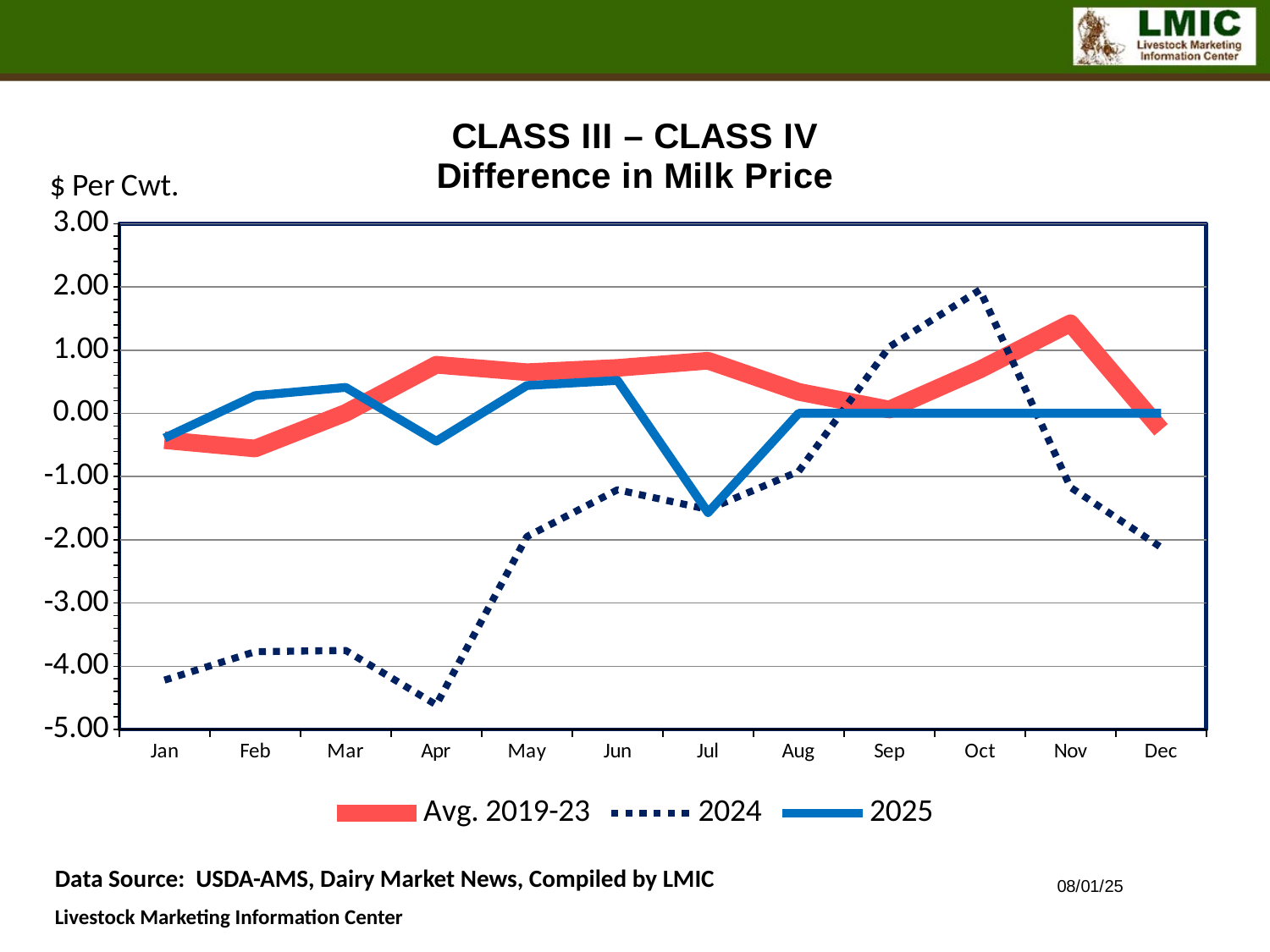
How many series does the legend list? 3 In which month does the 2024 series reach its lowest value? Apr How many months are shown along the x axis? 12 Is the 2025 value for Jul greater or less than -1.00? less Is the 2024 value for Apr greater or less than -4.00? less What kind of chart is shown on the slide? line chart Is the 2024 value for Oct greater or less than 1.00? greater Does the 2024 series generally rise or fall from Jan to Oct? rise In Jan, which series has the higher value: Avg. 2019-23 or 2024? Avg. 2019-23 What unit is shown on the y axis label? $ Per Cwt. In which month does the 2024 series reach its highest value? Oct In which month does the 2025 series reach its lowest value? Jul